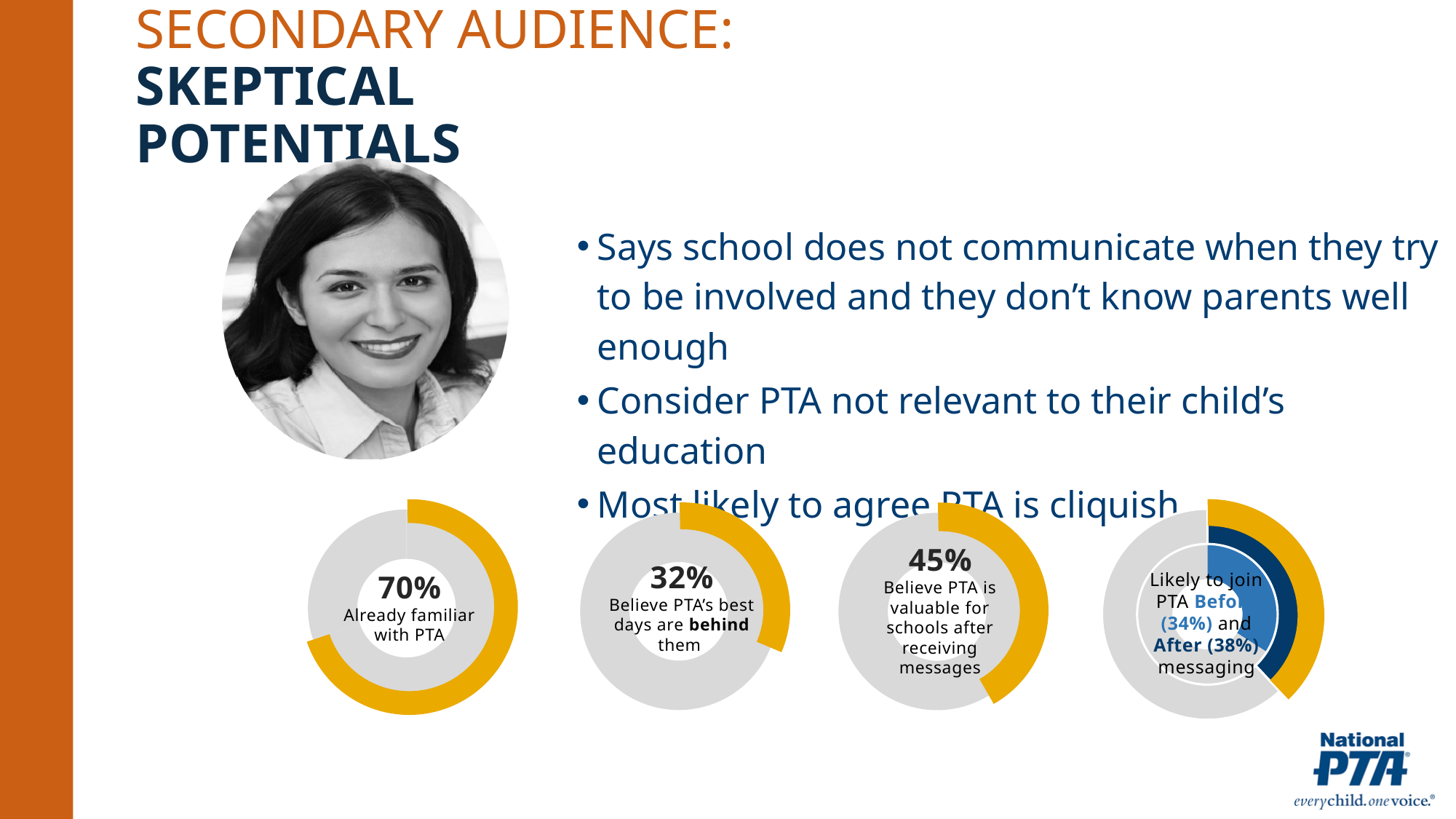
In the second donut chart from the left, what percentage believe PTA's best days are behind them? 32% What percentage of skeptical potentials are already familiar with PTA, according to the leftmost donut chart? 70% In the rightmost donut chart, by how many percentage points does the 'After' value exceed the 'Before' value? 4 What type of chart is used to display the percentages at the bottom of the slide? Donut (pie) chart Which of the four donut charts shows the highest percentage? Already familiar with PTA (70%) In the rightmost donut chart, what percentage are likely to join PTA before messaging? 34% How many donut charts are shown on the slide? 4 Which of the four donut charts shows the lowest single percentage? Believe PTA's best days are behind them (32%) In the rightmost donut chart, which is larger: likely to join PTA before messaging or after messaging? After (38%) In the rightmost donut chart, what percentage are likely to join PTA after messaging? 38% What is the difference between the 'Already familiar with PTA' value and the 'Believe PTA's best days are behind them' value? 38 percentage points In the third donut chart from the left, what percentage believe PTA is valuable for schools after receiving messages? 45%